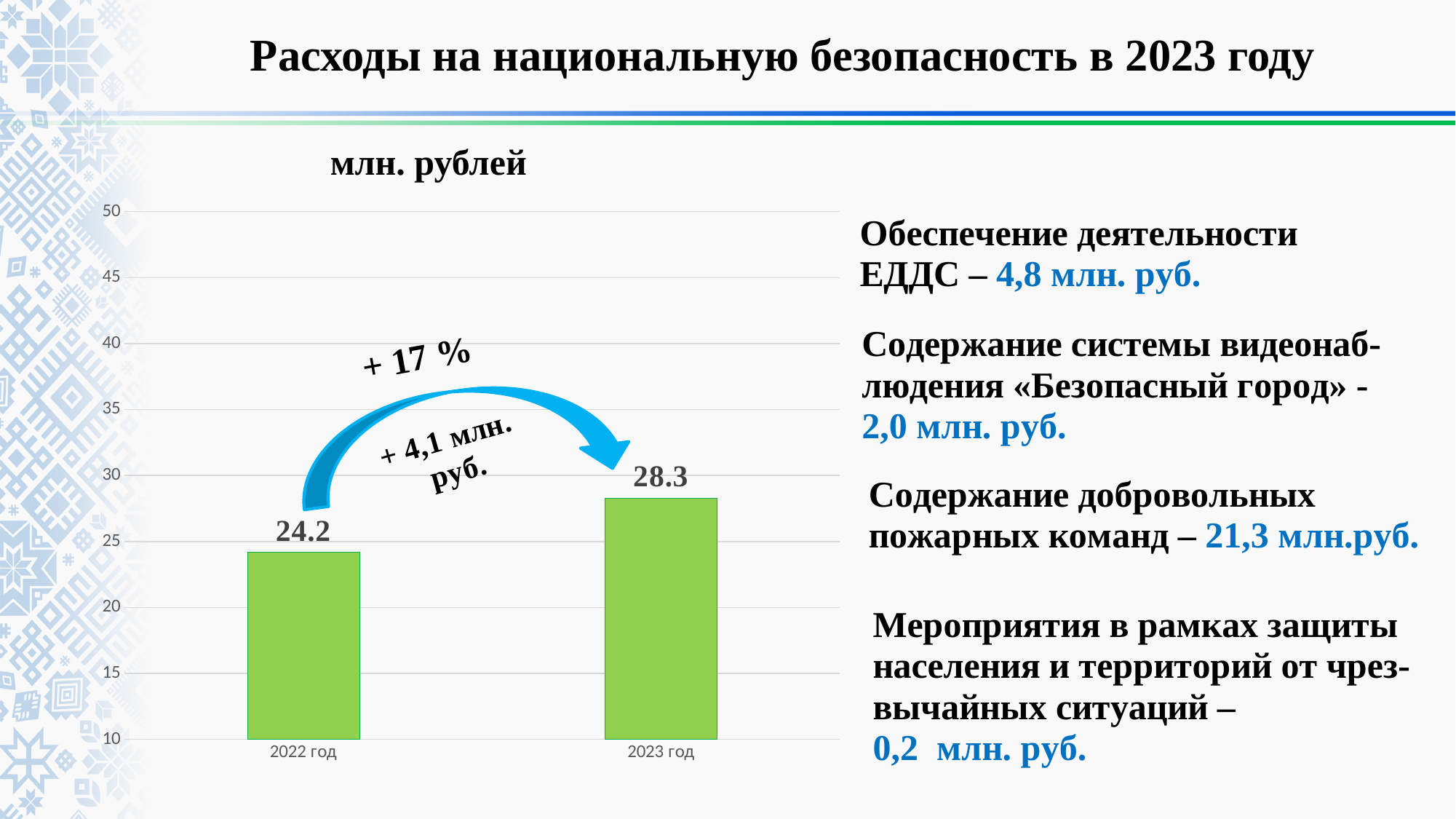
What unit is stated above the chart? млн. рублей What is the value for 2022 год? 24.2 What is the value for 2023 год? 28.3 What is the difference between the values for 2023 год and 2022 год? 4.1 Do the values rise or fall from 2022 год to 2023 год? rise Which year has the higher value? 2023 год Which year has the lower value? 2022 год Is the value for 2022 год larger or smaller than the value for 2023 год? smaller How many bars are shown in the chart? 2 Is the value for 2022 год greater or less than 30? less What kind of chart is shown on the slide? bar chart Is the value for 2023 год greater or less than 25? greater